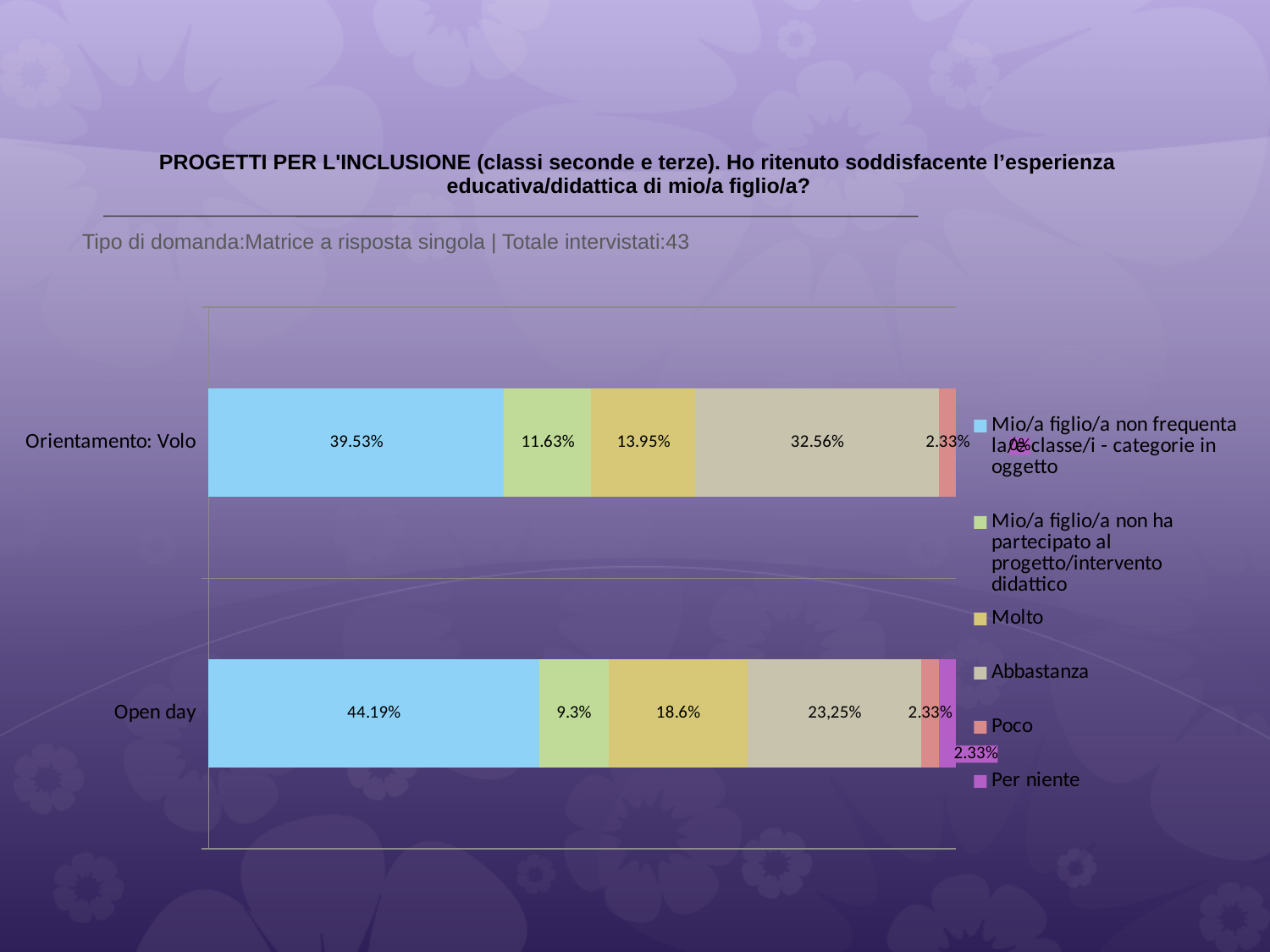
What is the difference between the 'Abbastanza' values for Orientamento: Volo and Open day? 9.31% What is the value of 'Molto' for Open day? 18.6% What is the value of 'Mio/a figlio/a non ha partecipato al progetto/intervento didattico' for Open day? 9.3% Which series is shown in light blue in the legend? Mio/a figlio/a non frequenta la/e classe/i - categorie in oggetto What is the value of 'Per niente' for Orientamento: Volo? 0% How many categories (bars) are plotted on the chart? 2 Which category has the higher value for 'Molto', Orientamento: Volo or Open day? Open day What is the value of 'Mio/a figlio/a non frequenta la/e classe/i - categorie in oggetto' for Orientamento: Volo? 39.53% What kind of chart is shown on the slide? stacked bar chart Which series has the largest value in the Open day bar? Mio/a figlio/a non frequenta la/e classe/i - categorie in oggetto What is the value of 'Abbastanza' for Orientamento: Volo? 32.56% How many series does the legend list? 6